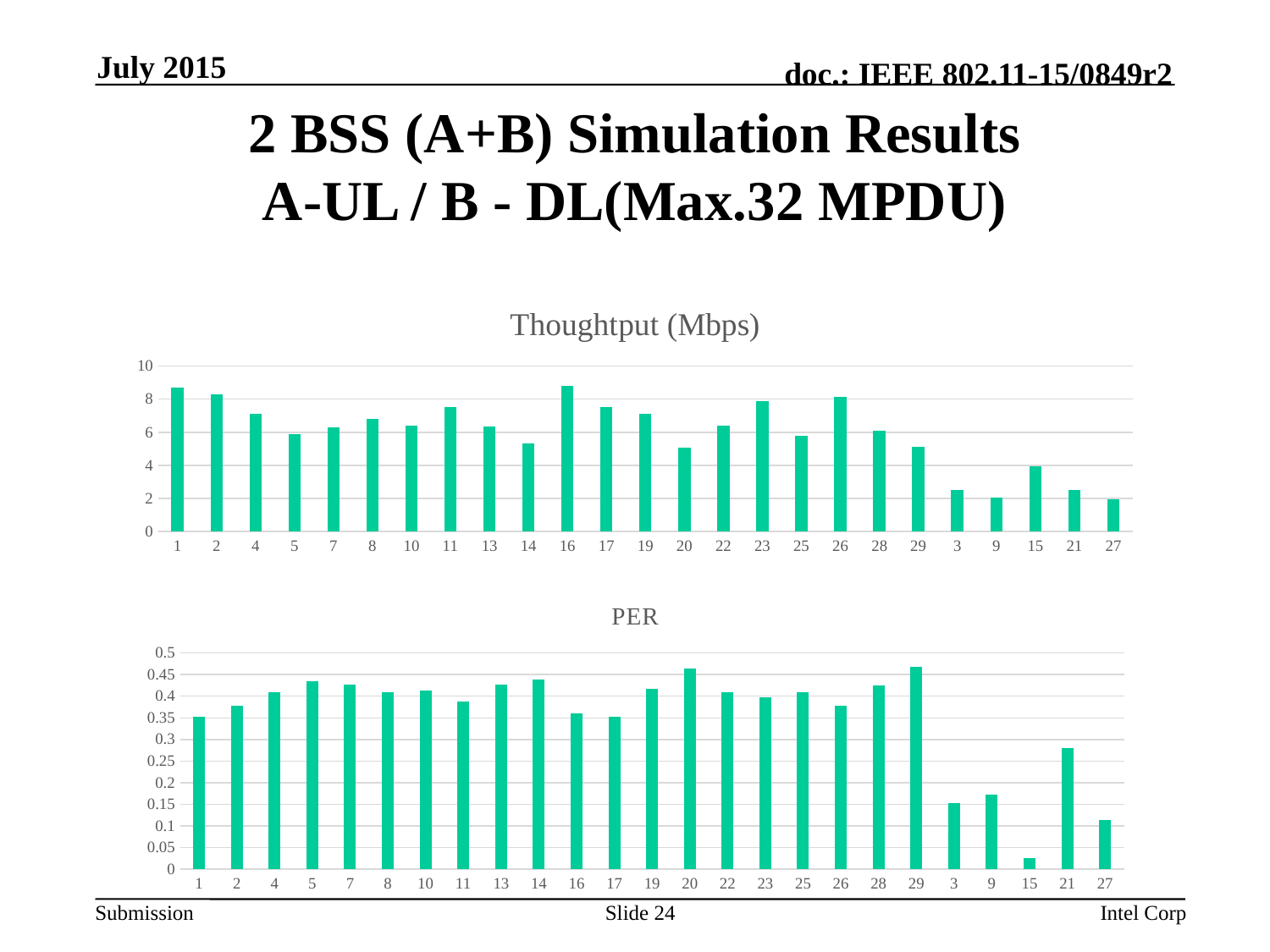
In the Thoughtput (Mbps) chart, is the value for category 1 greater or less than 8? greater In the PER chart, is the value for category 15 greater or less than 0.05? less In the Thoughtput (Mbps) chart, is the value for category 14 greater or less than 6? less In the PER chart, which category has the lowest value? 15 In the Thoughtput (Mbps) chart, which is larger, the value for category 1 or category 3? 1 How many categories are shown on the x axis of the PER chart? 25 What is the title of the top chart on the slide? Thoughtput (Mbps) What is the highest value shown on the y axis of the PER chart? 0.5 What kind of chart is the Thoughtput (Mbps) chart? bar chart In the PER chart, which is larger, the value for category 29 or category 15? 29